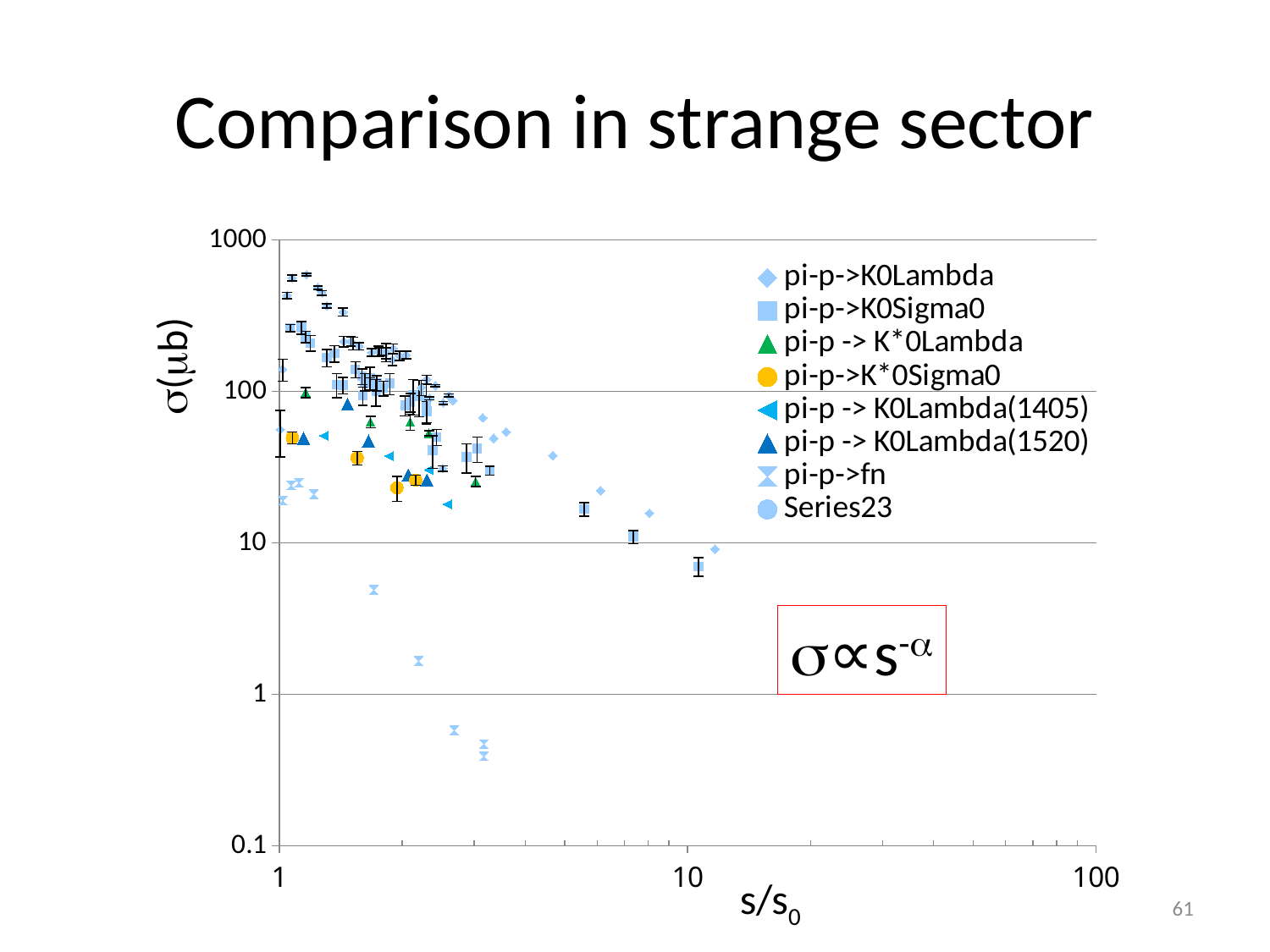
Are the lowest pi-p->fn points on the chart greater or less than 1 μb? less What is the maximum value shown on the y axis of the chart? 1000 Are the pi-p->K*0Sigma0 points greater or less than 100 μb? less How many series does the chart legend list? 8 What is the label of the x axis of the chart? s/s0 Do the cross-section values generally rise or fall as s/s0 increases along the x axis? fall What kind of chart is shown on the slide? scatter chart Which series reaches the lowest values on the chart? pi-p->fn What is the title of the slide containing the chart? Comparison in strange sector Are the highest pi-p->K0Sigma0 points near s/s0 = 1 greater or less than 100 μb? greater